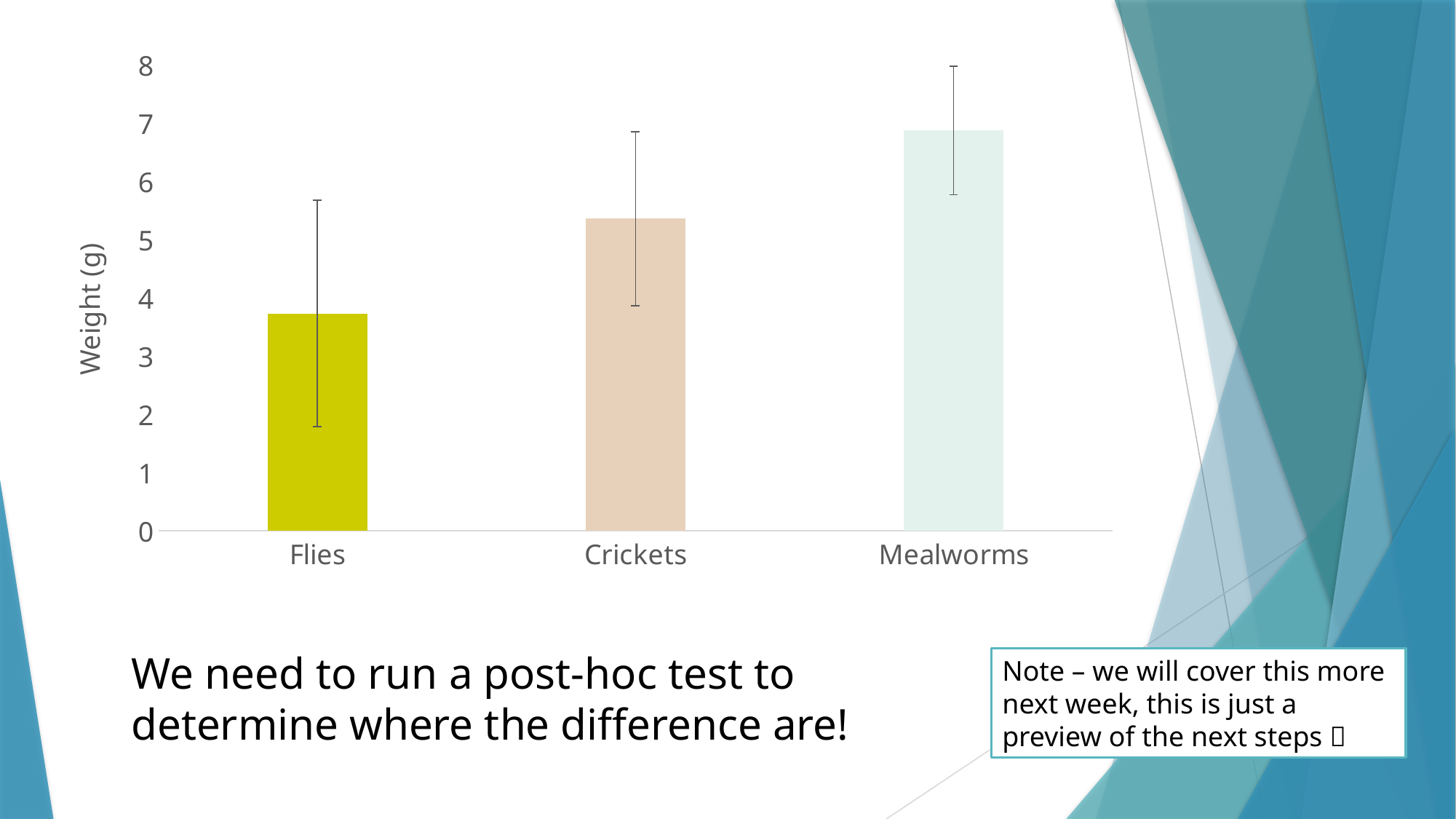
Which category has the lowest weight in the chart? Flies Which category has the highest weight in the chart? Mealworms Which has a larger weight value, Crickets or Flies? Crickets Is the value for Mealworms greater or less than 6? greater Is the value for Crickets greater or less than 6? less Which has a larger weight value, Mealworms or Crickets? Mealworms What is the title of the y axis of the chart? Weight (g) Do the bar values rise or fall moving from Flies to Mealworms along the x axis? Rise Is the value for Flies greater or less than 3? greater What kind of chart is shown on the slide? Bar chart How many categories are plotted on the x axis of the chart? 3